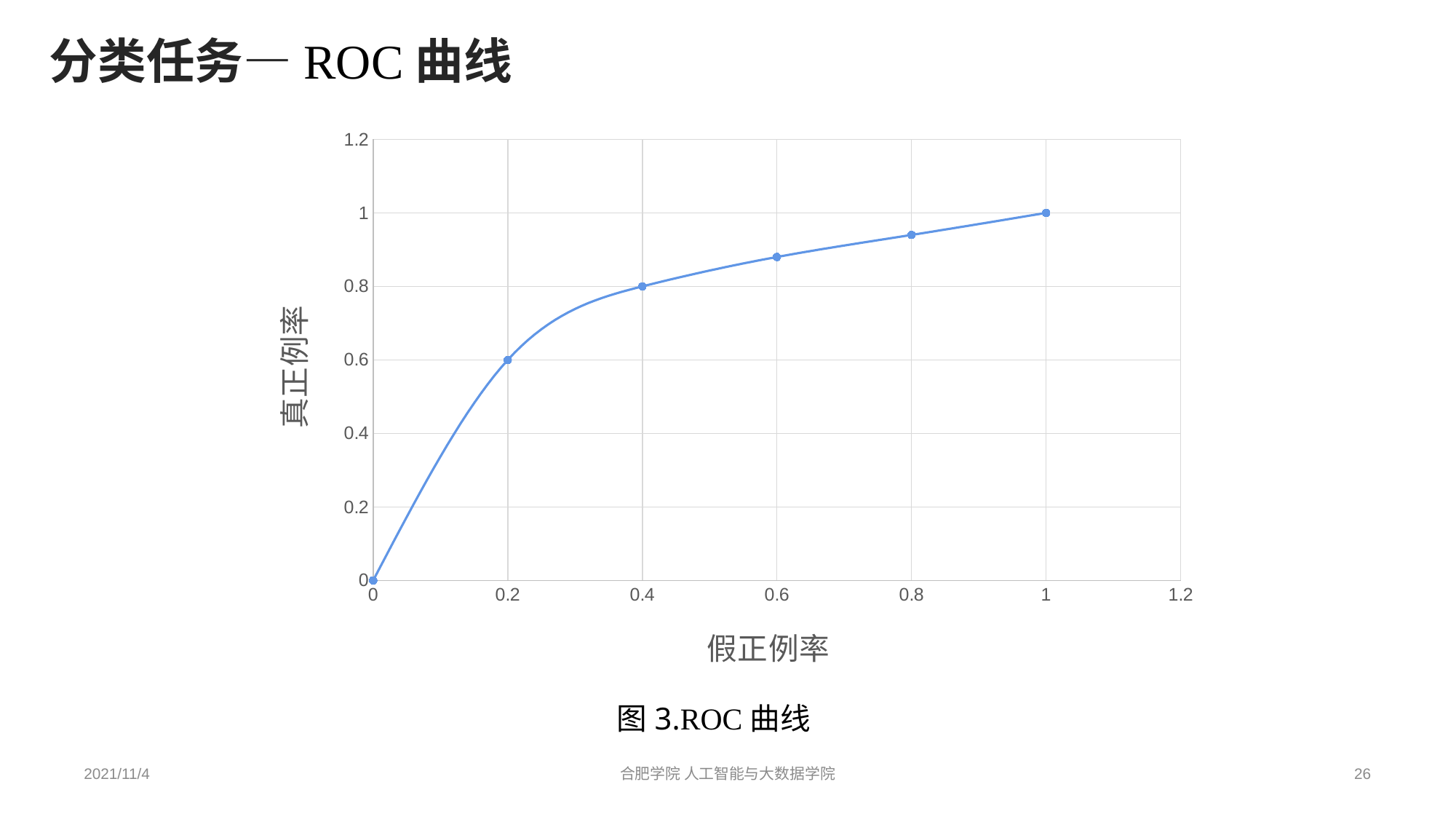
What is the difference between the 真正例率 values at 假正例率 0.4 and 0.2? 0.2 What is the 真正例率 value when 假正例率 is 0.2? 0.6 What is the label of the y axis? 真正例率 At which 假正例率 value is the 真正例率 highest? 1 What is the label of the x axis? 假正例率 Is the 真正例率 value at 假正例率 0.6 greater or less than 0.8? greater What is the 真正例率 value when 假正例率 is 0.4? 0.8 How many data points are plotted on the ROC curve? 6 What is the 真正例率 value when 假正例率 is 1? 1 Do the 真正例率 values rise or fall as 假正例率 increases along the x axis? rise What kind of chart is shown on the slide? line chart Is the 真正例率 value at 假正例率 0.8 greater or less than 1? less